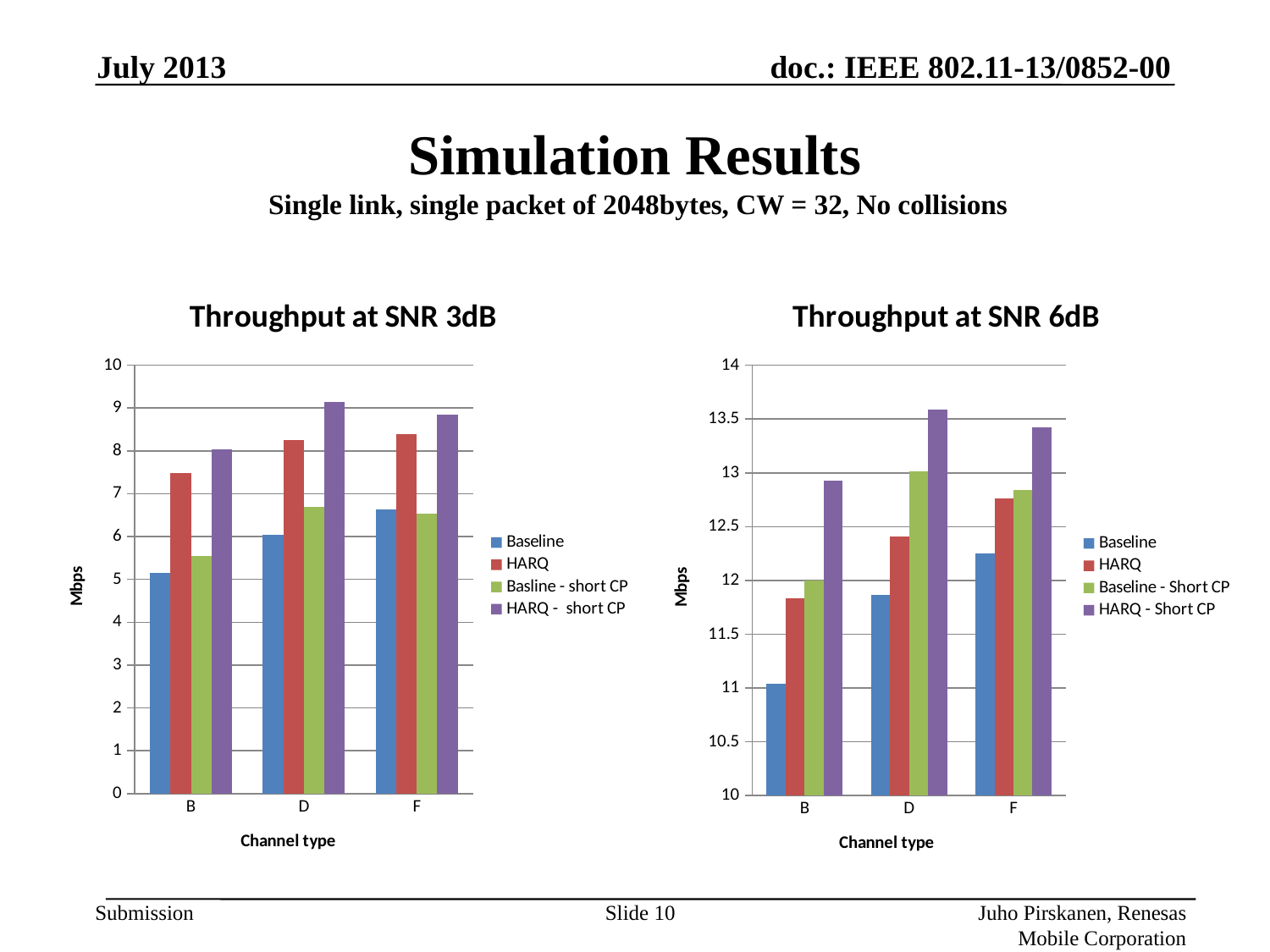
In the "Throughput at SNR 3dB" chart, which series has the lowest bar for channel type B? Baseline How many series does the legend of the "Throughput at SNR 3dB" chart list? 4 In the "Throughput at SNR 3dB" chart, is the HARQ - short CP value for channel type D greater or less than 8? greater In the "Throughput at SNR 3dB" chart, which channel type has the highest HARQ - short CP bar? D In the "Throughput at SNR 6dB" chart, does the Baseline series rise or fall from channel type B to F? rises How many channel types are shown on the x axis of the "Throughput at SNR 6dB" chart? 3 What is the y-axis label of the "Throughput at SNR 6dB" chart? Mbps In the "Throughput at SNR 3dB" chart, for channel type B, which is larger: Baseline or HARQ? HARQ What kind of chart is the "Throughput at SNR 3dB" chart? bar chart In the "Throughput at SNR 3dB" chart, is the Baseline value for channel type B greater or less than 6? less In the "Throughput at SNR 6dB" chart, is the HARQ - Short CP value for channel type D greater or less than 13? greater